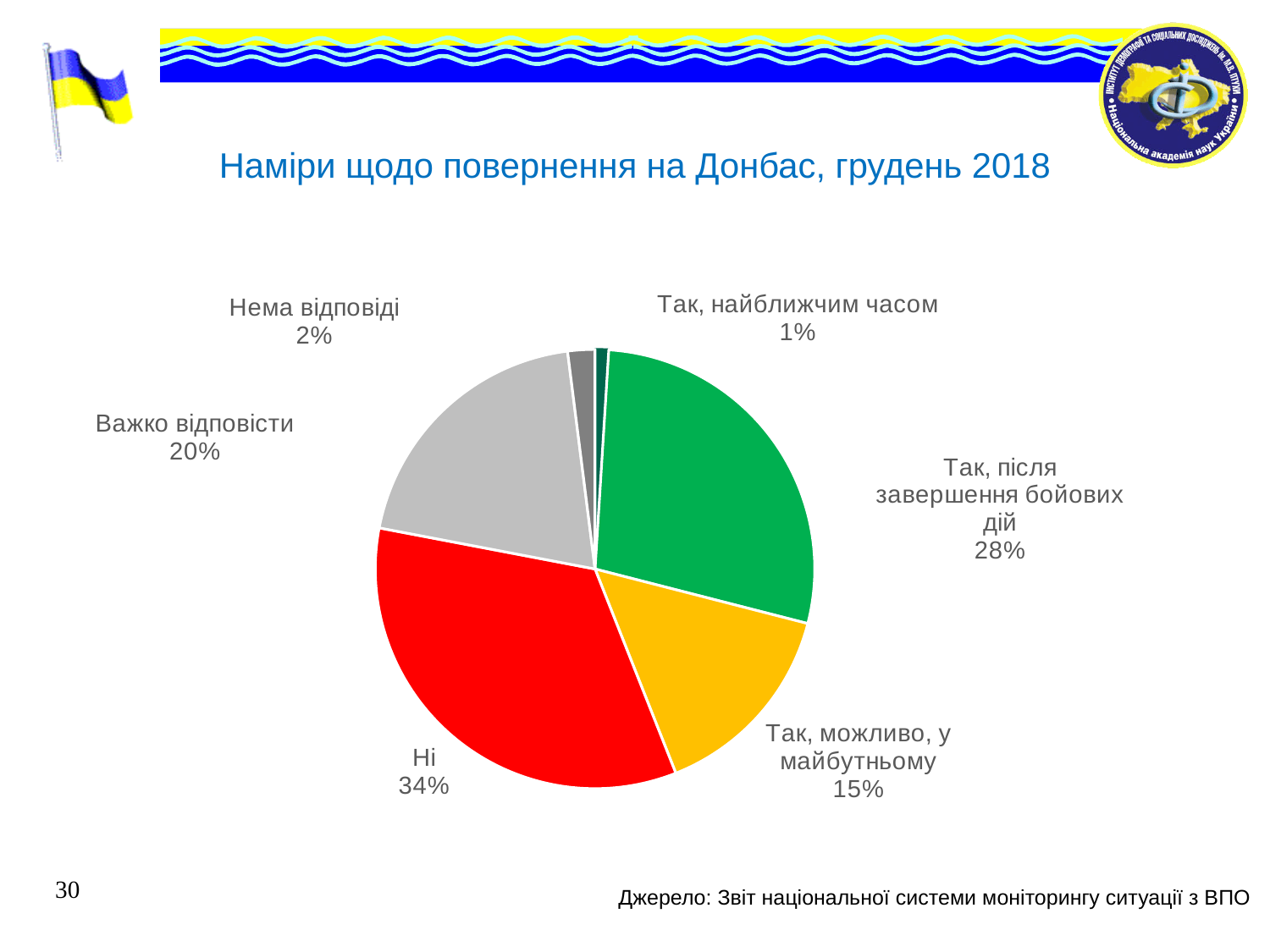
What colour is the slice for "Ні"? red What is the value for "Так, можливо, у майбутньому"? 15% What is the difference between the shares for "Ні" and "Так, після завершення бойових дій"? 6% What is the value for "Важко відповісти"? 20% Which category has the largest share of the pie? Ні What share of the pie is labelled "Ні"? 34% What is the title of the chart? Наміри щодо повернення на Донбас, грудень 2018 How many slices does the pie chart have? 6 What kind of chart is shown on the slide? pie chart Which is larger: the share for "Важко відповісти" or the share for "Так, можливо, у майбутньому"? Важко відповісти What is the value for "Так, після завершення бойових дій"? 28% Which category has the smallest share of the pie? Так, найближчим часом